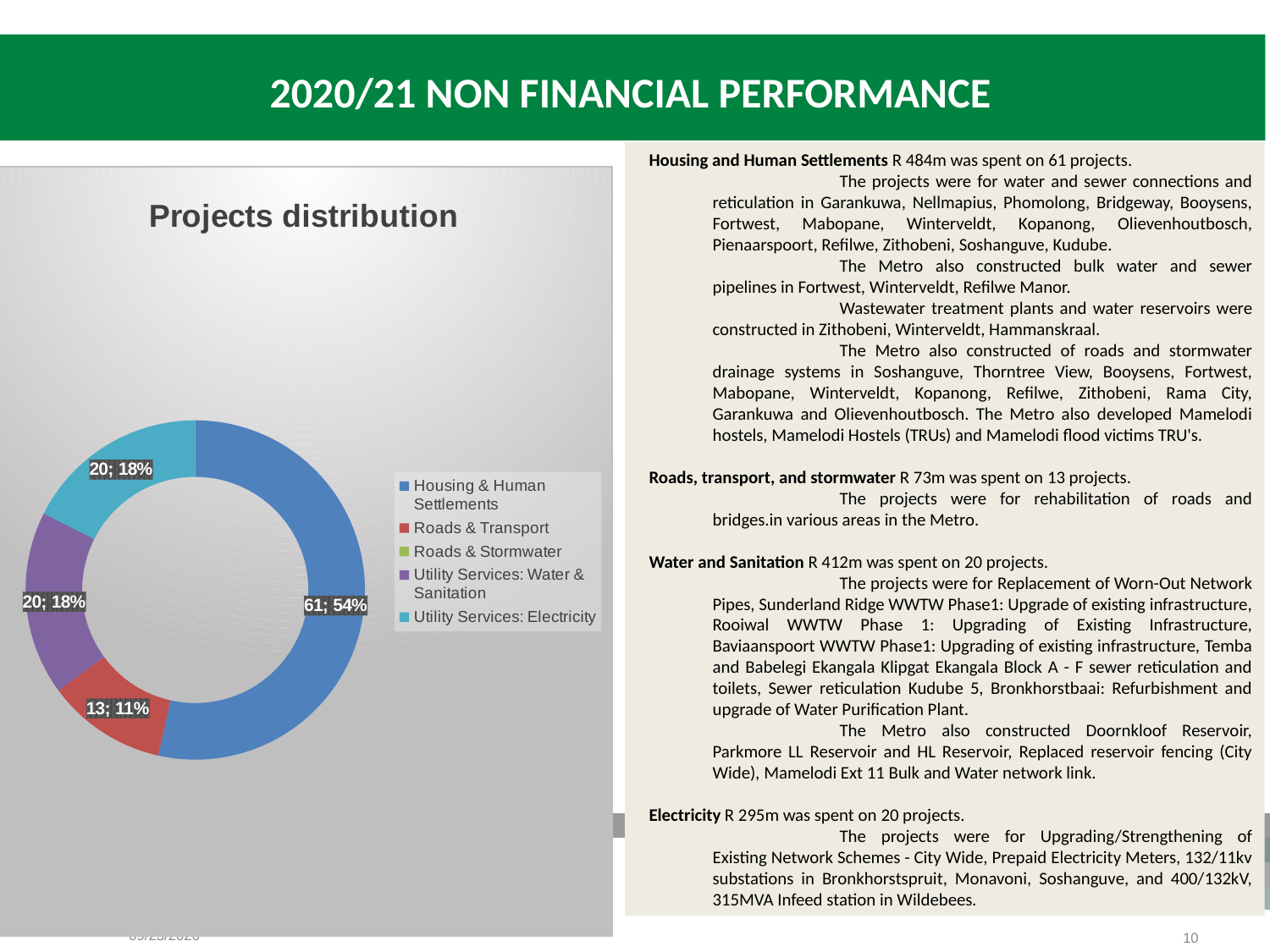
How many projects are shown for Roads & Transport? 13 Which has more projects, Housing & Human Settlements or Utility Services: Electricity? Housing & Human Settlements Which category has the largest slice of the chart? Housing & Human Settlements How many projects are shown for Housing & Human Settlements? 61 What is the difference between the number of projects for Housing & Human Settlements and for Roads & Transport? 48 What kind of chart is shown on the slide? doughnut chart What share of the chart does Utility Services: Electricity represent? 18% How many entries does the chart's legend list? 5 What is the title of the chart? Projects distribution What share of the chart does Roads & Transport represent? 11% How many projects are shown for Utility Services: Water & Sanitation? 20 What share of the chart does Housing & Human Settlements represent? 54%